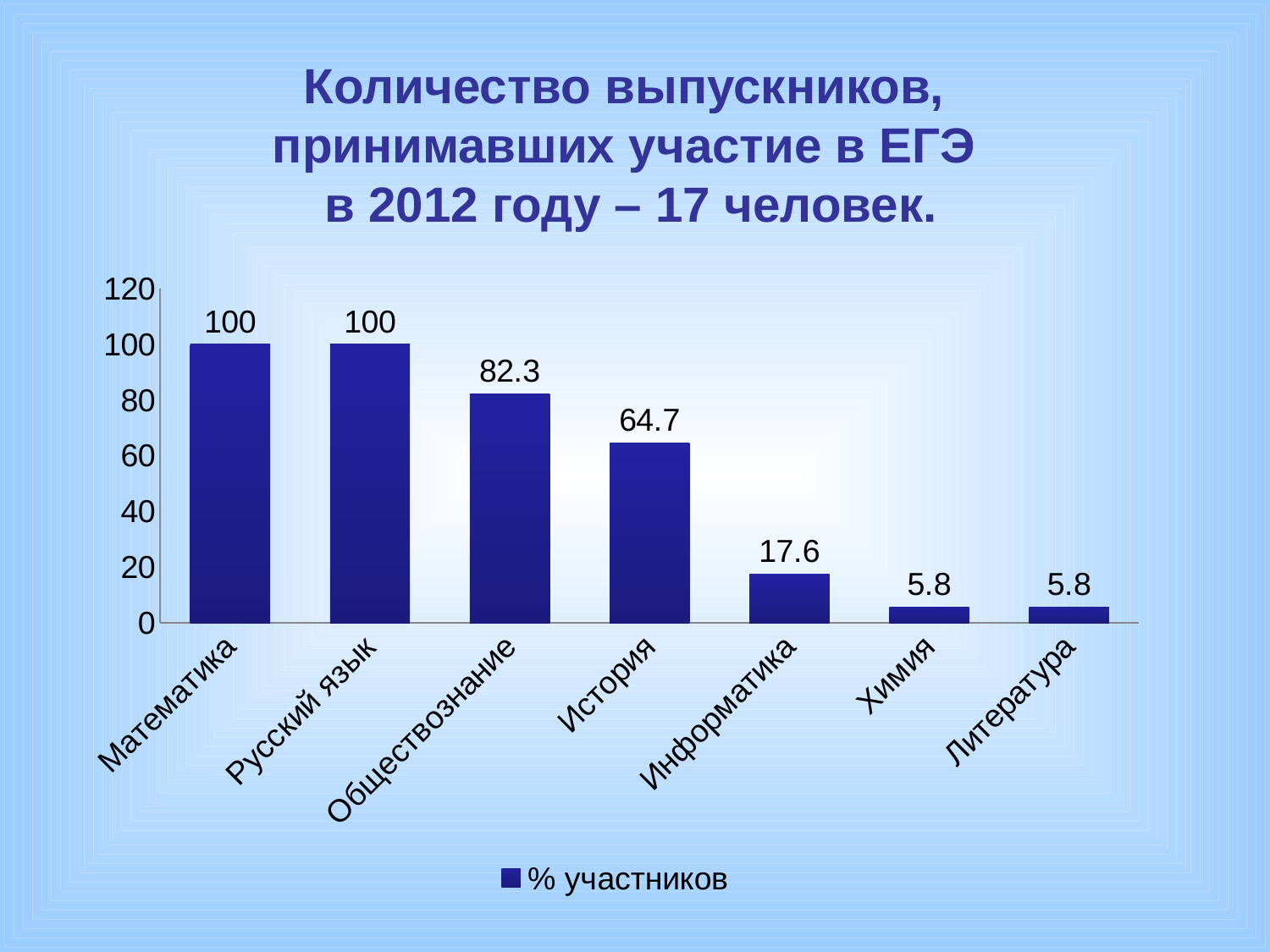
What is the legend entry for the series? % участников What is the value for Информатика? 17.6 What kind of chart is shown on the slide? Bar chart What is the value for Обществознание? 82.3 Which categories have the highest value? Математика and Русский язык Which categories have the lowest value? Химия and Литература How many categories are shown on the x axis? 7 What is the value for Химия? 5.8 Which is larger, the value for История or the value for Информатика? История What is the value for История? 64.7 What is the difference between the values for Обществознание and История? 17.6 How many series does the legend list? 1